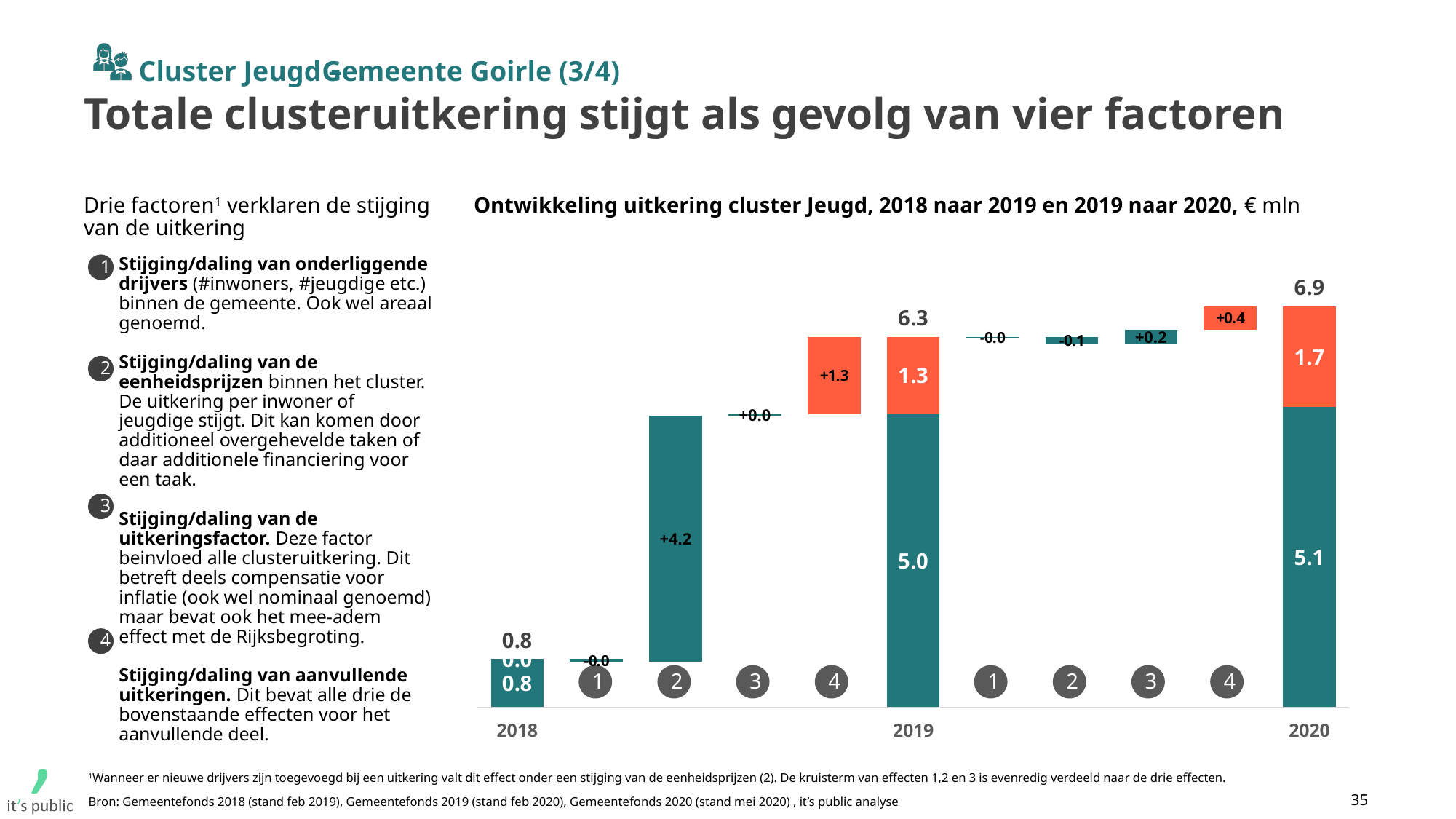
What is the value of the orange (upper) segment of the 2019 bar? 1.3 What is the total uitkering for cluster Jeugd in 2019? 6.3 Which year has the highest total uitkering? 2020 What is the effect of factor 2 on the change from 2019 to 2020? -0.1 What is the effect of factor 4 (aanvullende uitkeringen) on the change from 2018 to 2019? +1.3 What is the effect of factor 4 on the change from 2019 to 2020? +0.4 What is the effect of factor 2 (eenheidsprijzen) on the change from 2018 to 2019? +4.2 In what unit are the values in the chart expressed? € mln What is the value of the teal (lower) segment of the 2020 bar? 5.1 By how much does the total uitkering increase from 2019 to 2020? 0.6 What is the total uitkering for cluster Jeugd in 2018? 0.8 What is the total uitkering for cluster Jeugd in 2020? 6.9